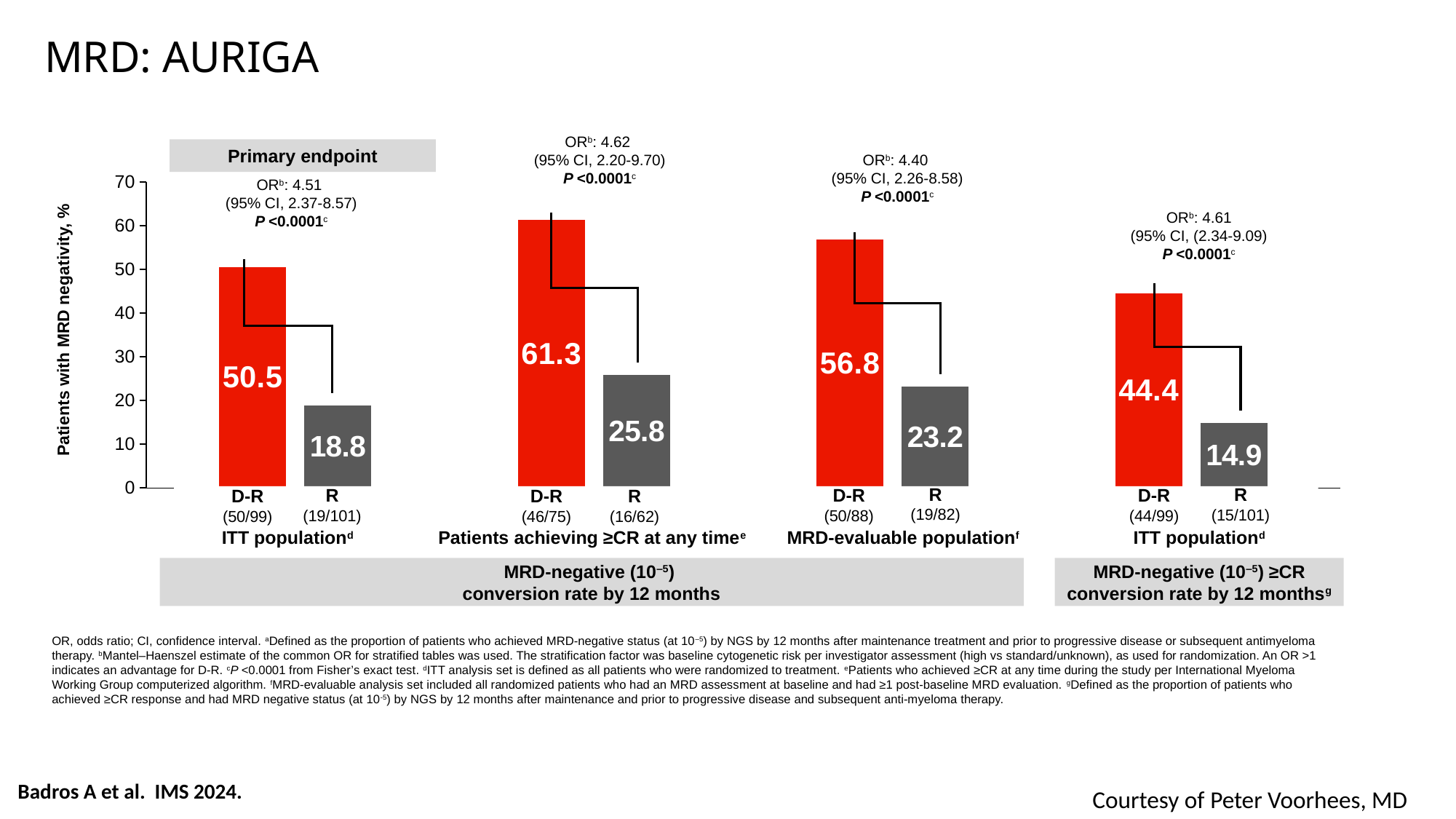
What is the label of the y-axis? Patients with MRD negativity, % What type of chart is shown on the slide? Bar chart What is the difference between D-R and R in the ITT population for MRD-negative (10⁻⁵) conversion rate by 12 months? 31.7 What is the value for R among patients achieving ≥CR at any time? 25.8 Which is larger: the D-R value in the MRD-evaluable population or the D-R value among patients achieving ≥CR at any time? Patients achieving ≥CR at any time (61.3) Which bar on the chart has the lowest value? R, ITT population for MRD-negative ≥CR conversion rate (14.9) What is the difference between D-R and R in the MRD-evaluable population? 33.6 How many bars are plotted on the chart? 8 What is the value for D-R in the MRD-evaluable population? 56.8 Which bar on the chart has the highest value? D-R, patients achieving ≥CR at any time (61.3) What is the value for R in the ITT population for MRD-negative (10⁻⁵) ≥CR conversion rate by 12 months? 14.9 What is the MRD negativity rate for D-R in the ITT population under MRD-negative (10⁻⁵) conversion rate by 12 months? 50.5